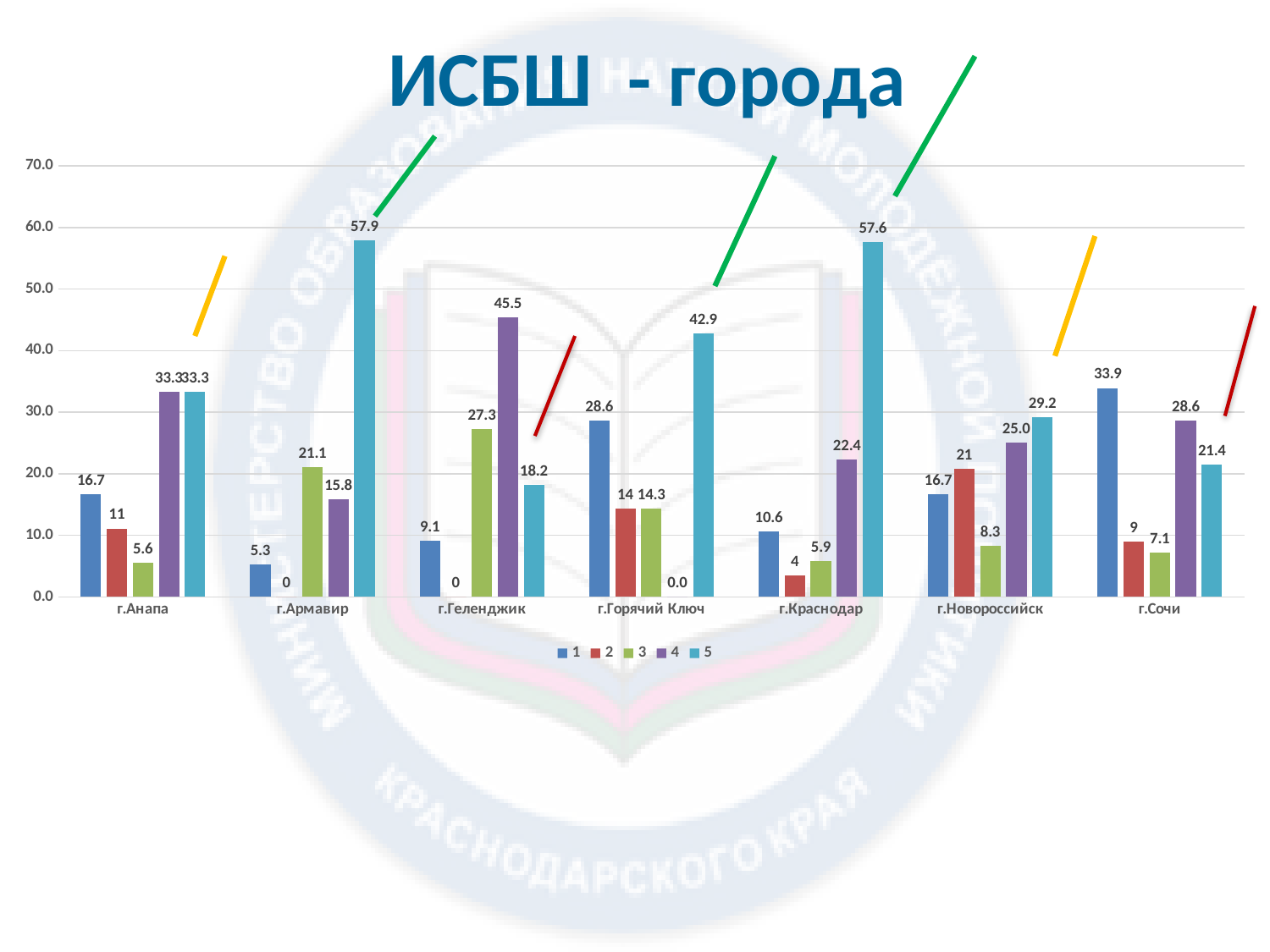
Which city has the larger value for series 1, г.Горячий Ключ or г.Сочи? г.Сочи What is the difference between series 5 and series 4 for г.Краснодар? 35.2 How many series does the legend list? 5 What is the value of series 5 for г.Армавир? 57.9 What is the title of the chart? ИСБШ - города What is the value of series 4 for г.Геленджик? 45.5 What is the value of series 1 for г.Сочи? 33.9 How many cities are shown on the x axis? 7 Which city has the highest value for series 5? г.Армавир What is the value of series 2 for г.Новороссийск? 21 What kind of chart is shown on the slide? Bar chart Which city has the lowest value for series 1? г.Армавир